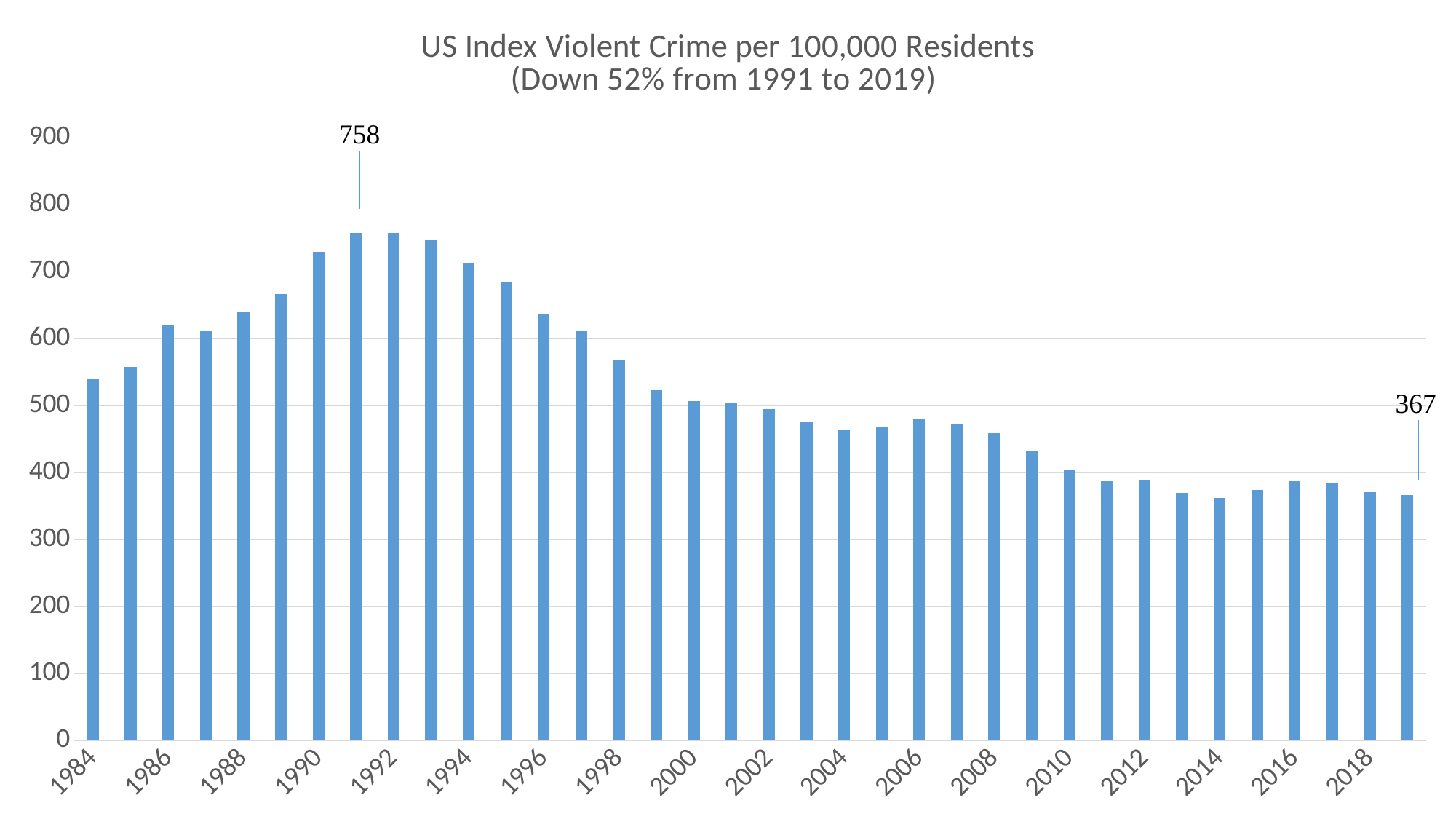
Is the value for 2016 greater or less than 400? less Which year has the larger value, 1984 or 1990? 1990 What is the value for 2019? 367 What is the value for 1991? 758 How many bars (years) are plotted in the chart? 36 What kind of chart is shown on the slide? Bar chart Is the value for 1984 greater or less than 500? greater Do the values rise or fall from 1992 to 2019? fall Is the value for 1990 greater or less than 700? greater What is the title of the chart? US Index Violent Crime per 100,000 Residents (Down 52% from 1991 to 2019) What is the difference between the 1991 value and the 2019 value? 391